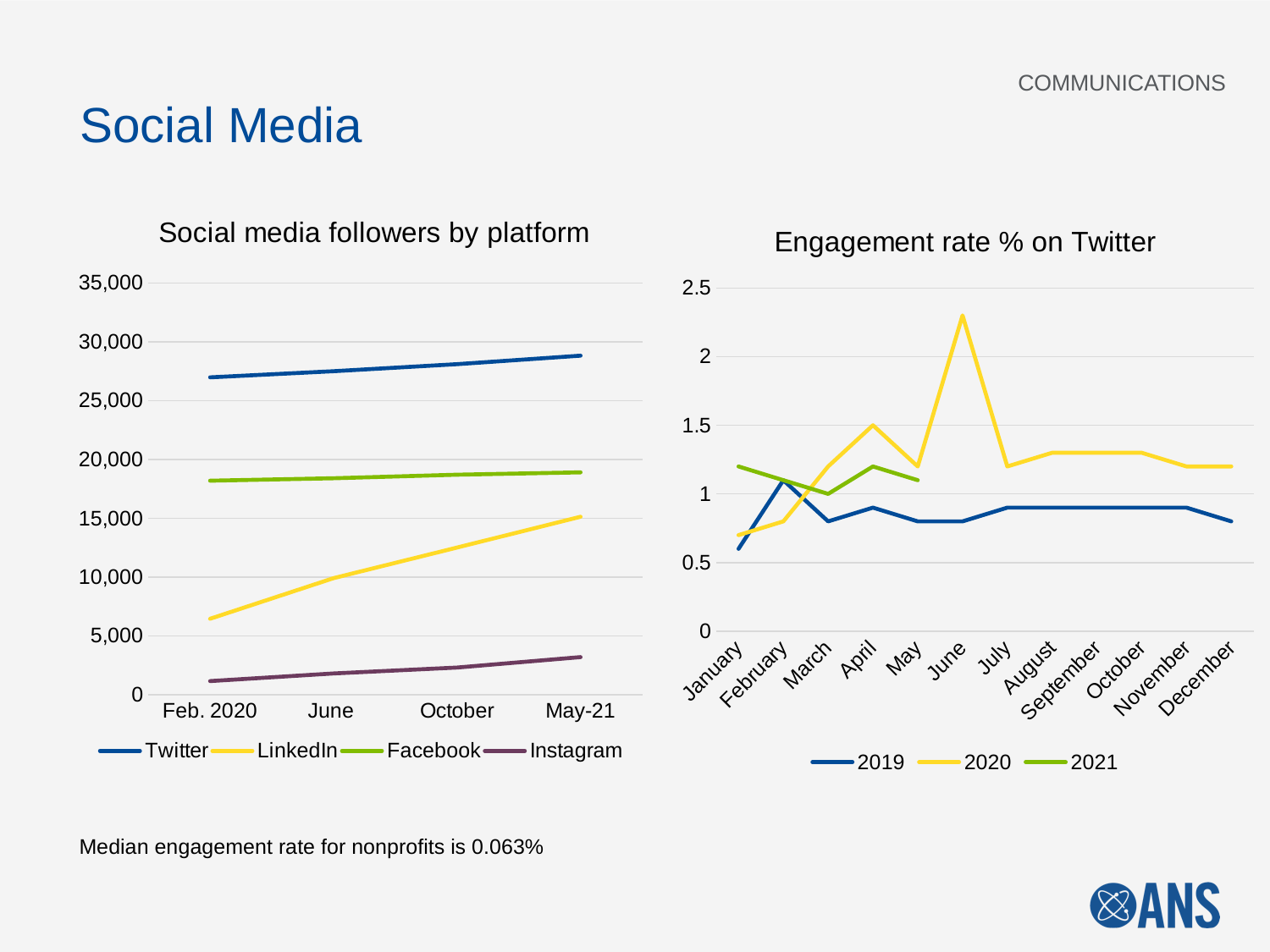
In "Engagement rate % on Twitter", in which month does the 2020 series reach its highest value? June How many series does the legend of "Engagement rate % on Twitter" list? 3 In "Social media followers by platform", which platform has the fewest followers? Instagram In "Social media followers by platform", which has more followers in May-21, Facebook or LinkedIn? Facebook In "Social media followers by platform", which platform has the most followers? Twitter In "Social media followers by platform", do LinkedIn followers rise or fall from Feb. 2020 to May-21? rise In "Social media followers by platform", is the Instagram value for May-21 greater or less than 5,000? less In "Social media followers by platform", is the Twitter value for Feb. 2020 greater or less than 25,000? greater In "Engagement rate % on Twitter", is the 2020 value for June greater or less than 2? greater How many series does the legend of "Social media followers by platform" list? 4 How many months are shown on the x axis of "Engagement rate % on Twitter"? 12 What type of chart is "Social media followers by platform"? line chart